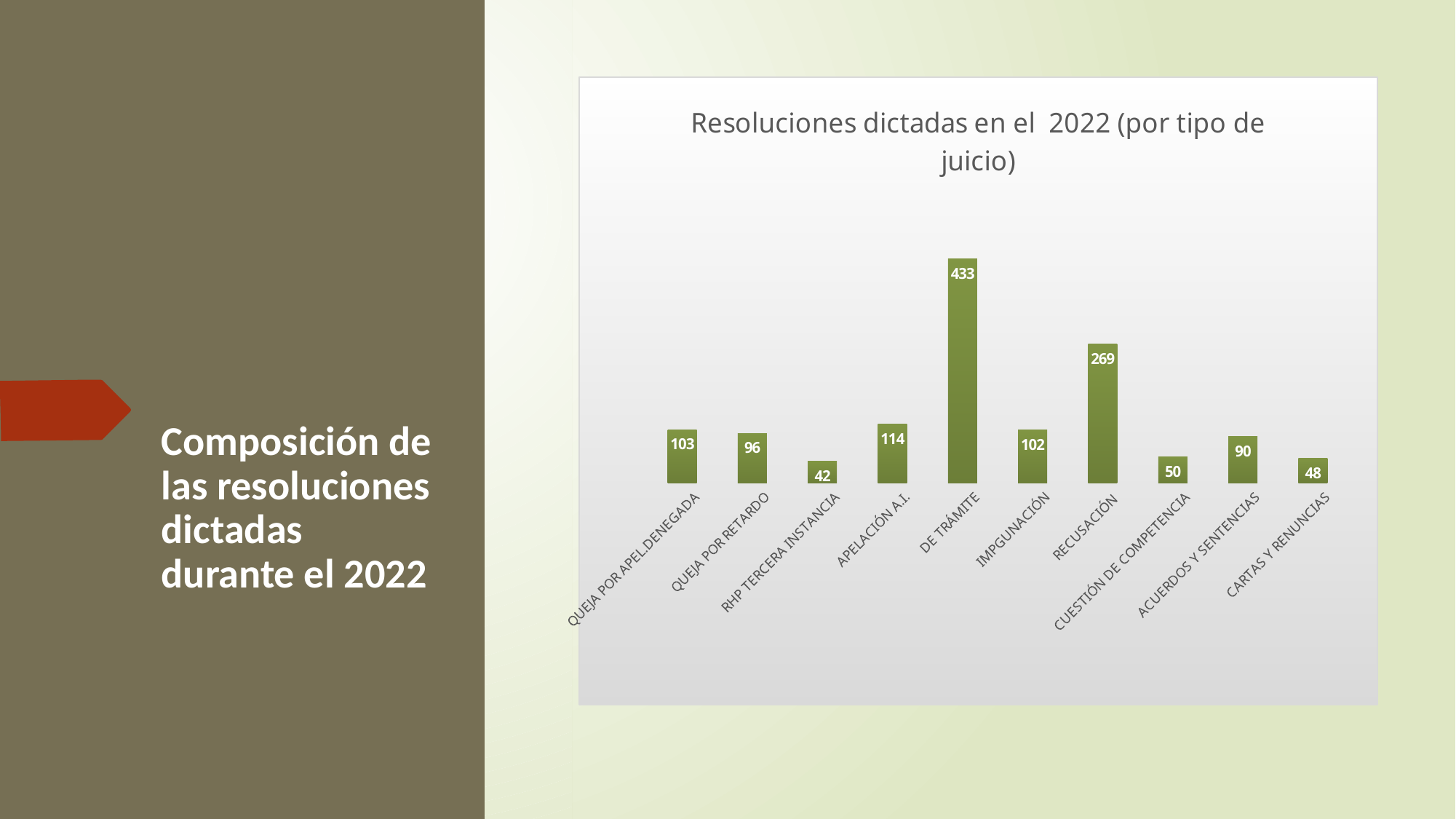
What kind of chart is shown on the slide? Bar chart Which category has the highest value? DE TRÁMITE What is the title of the chart? Resoluciones dictadas en el 2022 (por tipo de juicio) How many categories are shown in the chart? 10 What is the value for RHP TERCERA INSTANCIA? 42 What is the difference between the values for APELACIÓN A.I. and QUEJA POR RETARDO? 18 Which is larger, the value for QUEJA POR APEL. DENEGADA or the value for IMPGUNACIÓN? QUEJA POR APEL. DENEGADA What is the value for DE TRÁMITE? 433 What is the value for ACUERDOS Y SENTENCIAS? 90 What is the difference between the values for DE TRÁMITE and RECUSACIÓN? 164 Which category has the lowest value? RHP TERCERA INSTANCIA What is the value for RECUSACIÓN? 269